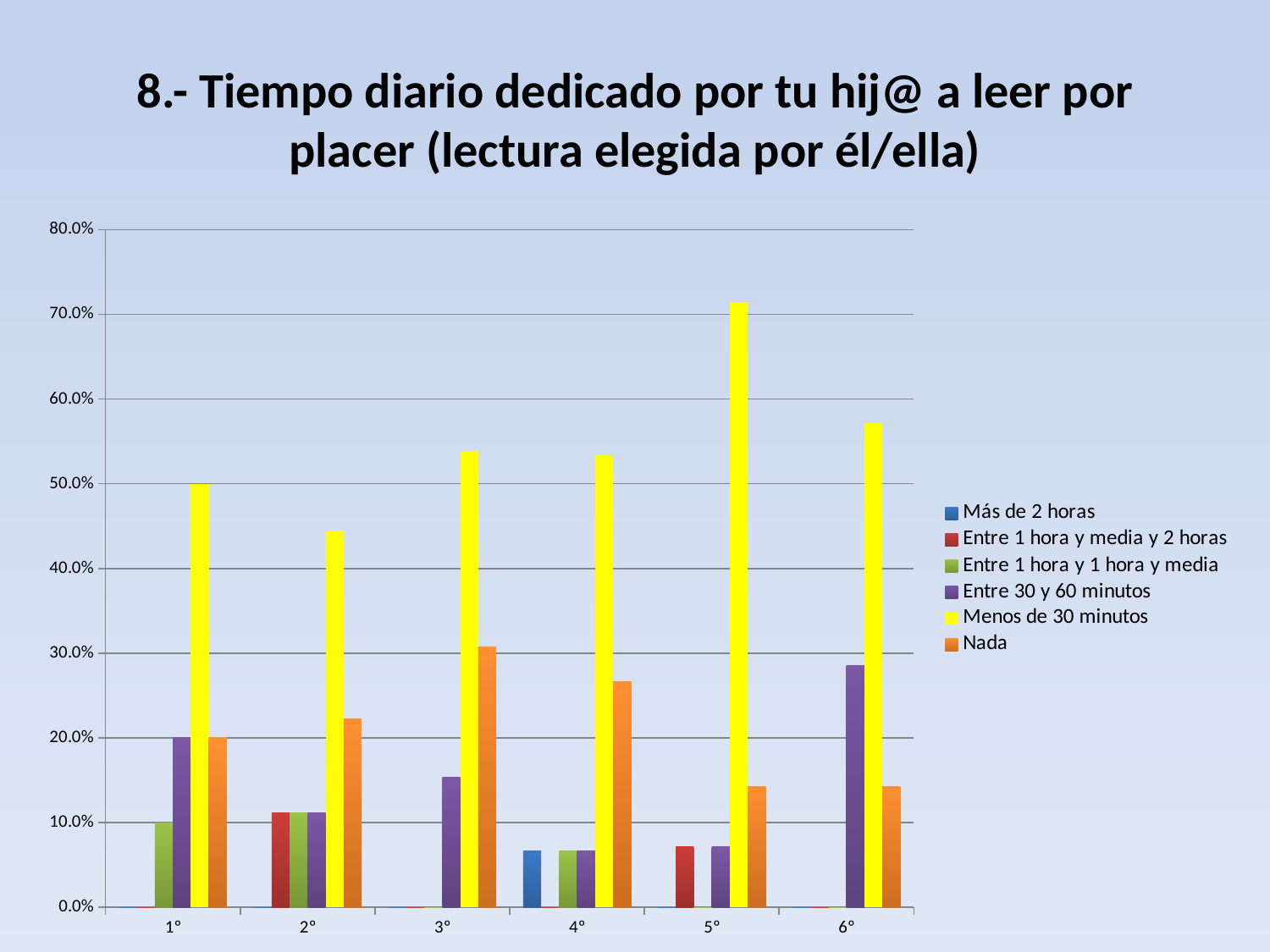
Is the value for 'Entre 1 hora y 1 hora y media' in 2° greater or less than 20%? less Which grade has the highest value for 'Entre 30 y 60 minutos'? 6° How many series does the legend list? 6 Which grade has the lowest value for 'Menos de 30 minutos'? 2° Is the value for 'Menos de 30 minutos' in 5° greater or less than 60%? greater Is the value for 'Entre 30 y 60 minutos' in 6° greater or less than 20%? greater What kind of chart is shown on the slide? bar chart Which grade has the highest value for 'Menos de 30 minutos'? 5° In 3°, which is larger: 'Nada' or 'Entre 30 y 60 minutos'? Nada What colour represents 'Menos de 30 minutos' in the legend? yellow Which grade has the highest value for 'Nada'? 3° How many grade categories are shown on the x axis? 6